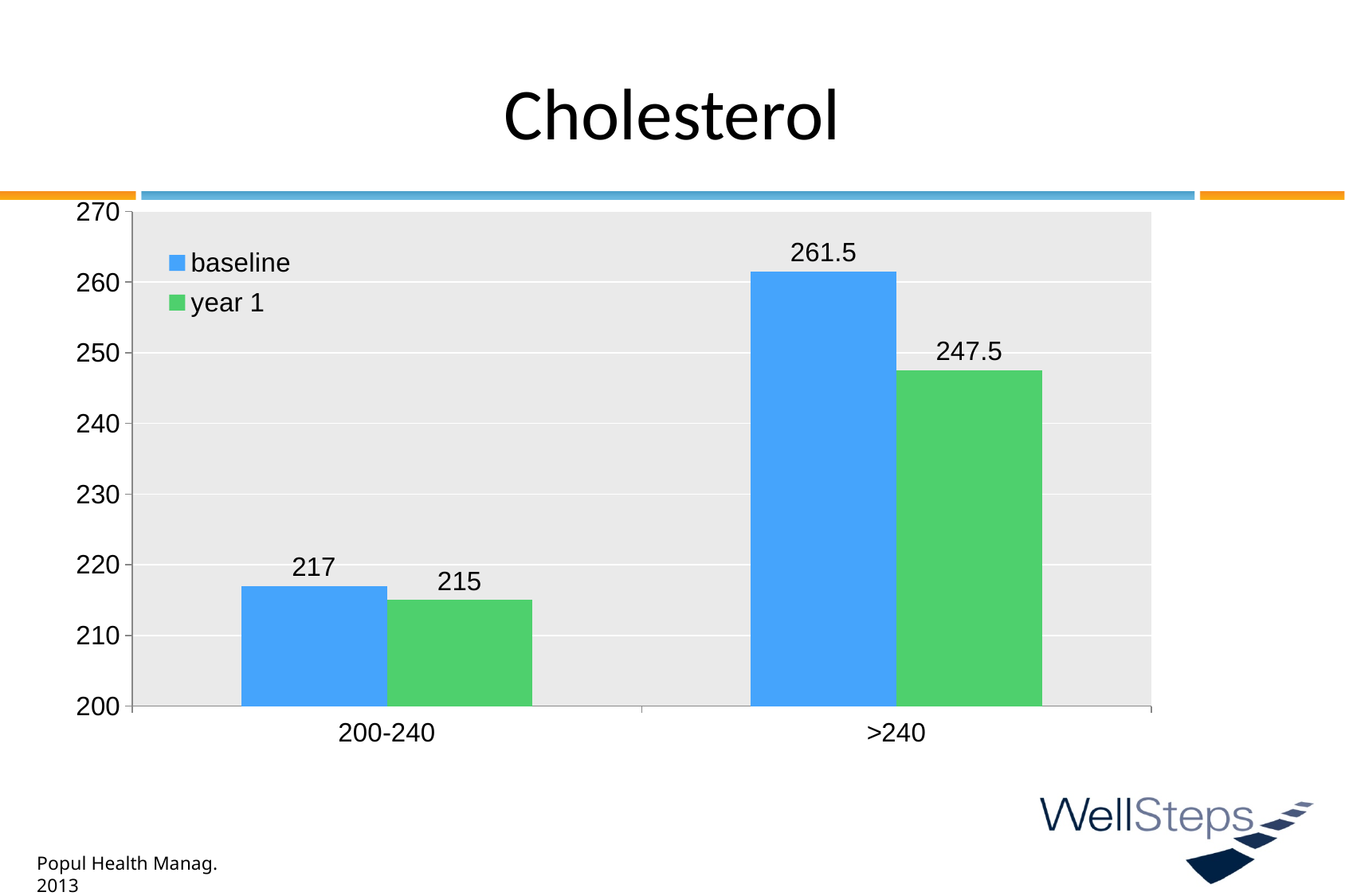
Which bar has the lowest value on the chart? year 1, 200-240 What is the baseline value for the >240 category? 261.5 How many categories are shown on the x axis? 2 What is the difference between the baseline and year 1 values for the 200-240 category? 2 What is the baseline value for the 200-240 category? 217 What is the year 1 value for the >240 category? 247.5 What is the year 1 value for the 200-240 category? 215 Which bar has the highest value on the chart? baseline, >240 What kind of chart is shown on the slide? bar chart What is the difference between the baseline and year 1 values for the >240 category? 14 How many series does the legend list? 2 Which is larger for the >240 category, baseline or year 1? baseline